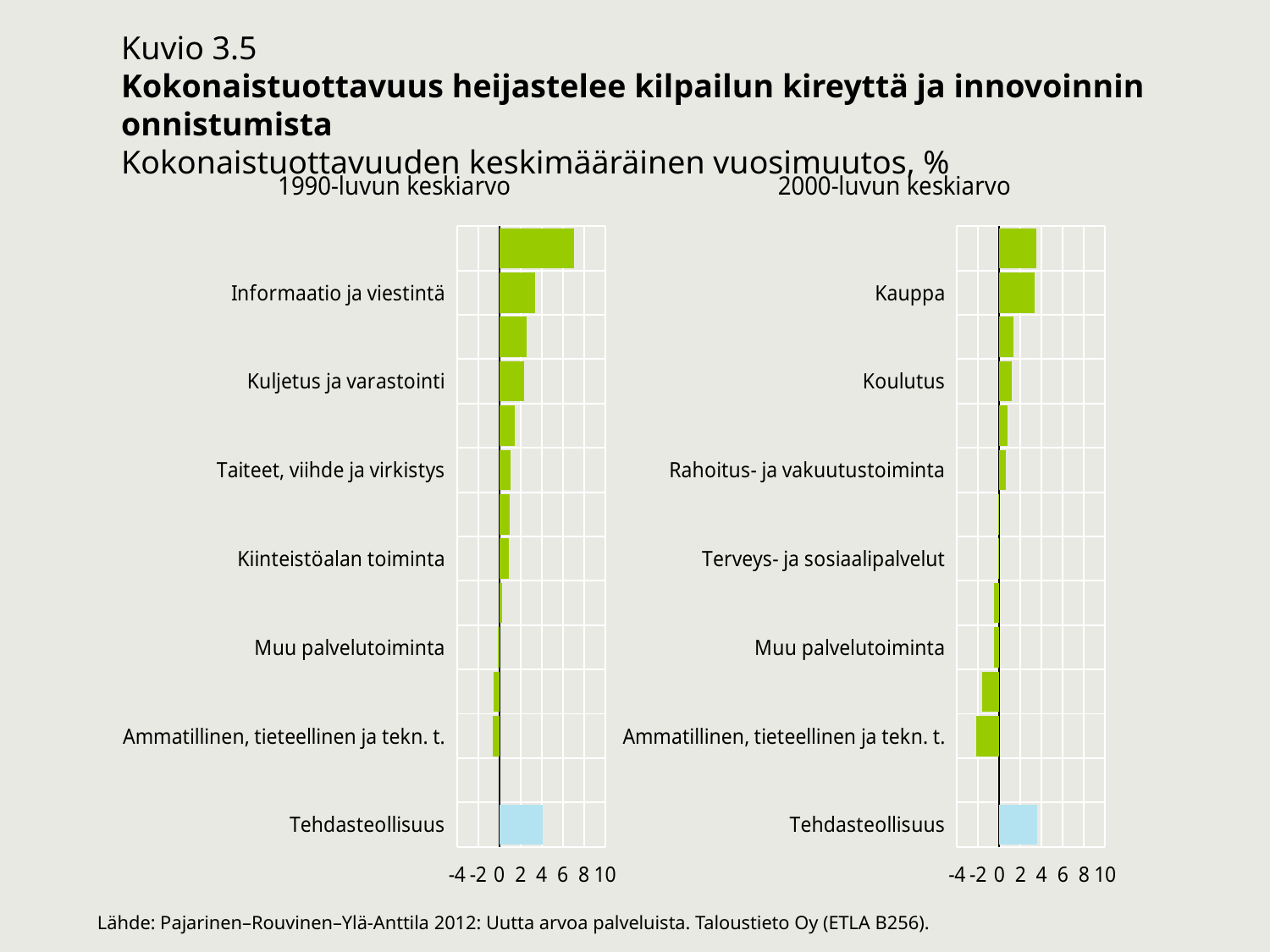
In the 2000-luvun keskiarvo chart, which is larger: Kauppa or Koulutus? Kauppa In the 2000-luvun keskiarvo chart, is the value for Tehdasteollisuus greater or less than 2? greater In the 2000-luvun keskiarvo chart, which is larger: Koulutus or Ammatillinen, tieteellinen ja tekn. t.? Koulutus In the 1990-luvun keskiarvo chart, which is larger: Informaatio ja viestintä or Taiteet, viihde ja virkistys? Informaatio ja viestintä In the 2000-luvun keskiarvo chart, is the value for Kauppa greater or less than 2? greater In the 1990-luvun keskiarvo chart, is the value for Informaatio ja viestintä greater or less than 2? greater How many category labels are printed next to the 2000-luvun keskiarvo chart? 7 In both charts, which category's bar is drawn in light blue instead of green? Tehdasteollisuus What kind of chart is used for the 1990-luvun keskiarvo panel? Bar chart